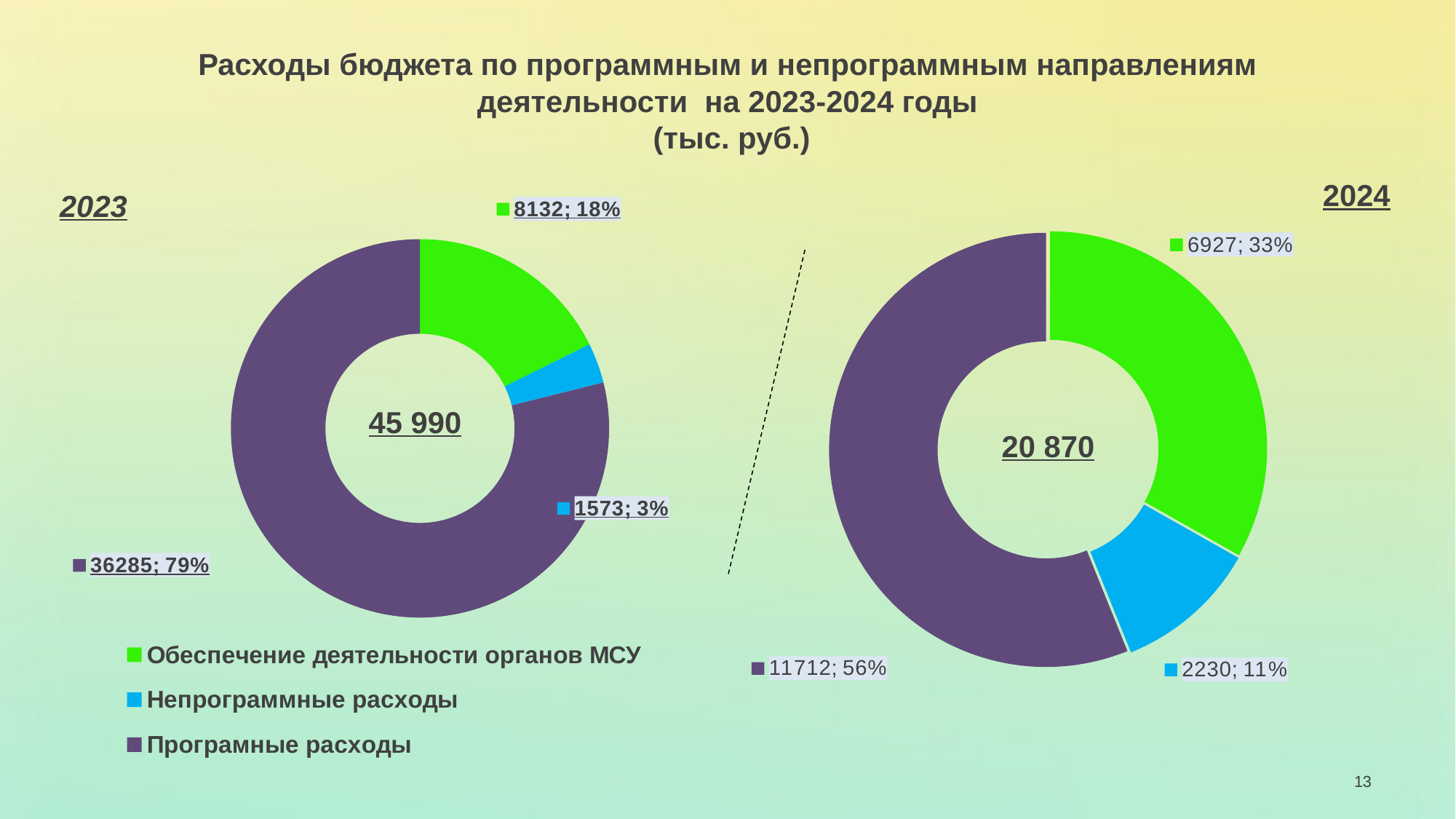
In the 2024 chart, what share of the total is Обеспечение деятельности органов МСУ? 33% How many categories does the legend list? 3 Which is larger: Обеспечение деятельности органов МСУ in 2023 or in 2024? 2023 In the 2024 chart, which category has the smallest value? Непрограммные расходы Which colour represents Непрограммные расходы in the legend? Blue What kind of chart is used for the 2023 data? Doughnut chart In the 2023 chart, which category has the largest value? Програмные расходы In the 2024 chart, what is the value for Непрограммные расходы? 2230 In the 2023 chart, what share of the total is Непрограммные расходы? 3% In the 2023 chart, what is the value for Програмные расходы? 36285 In the 2023 chart, what is the difference between Програмные расходы and Обеспечение деятельности органов МСУ? 28153 What total is shown in the centre of the 2024 chart? 20 870